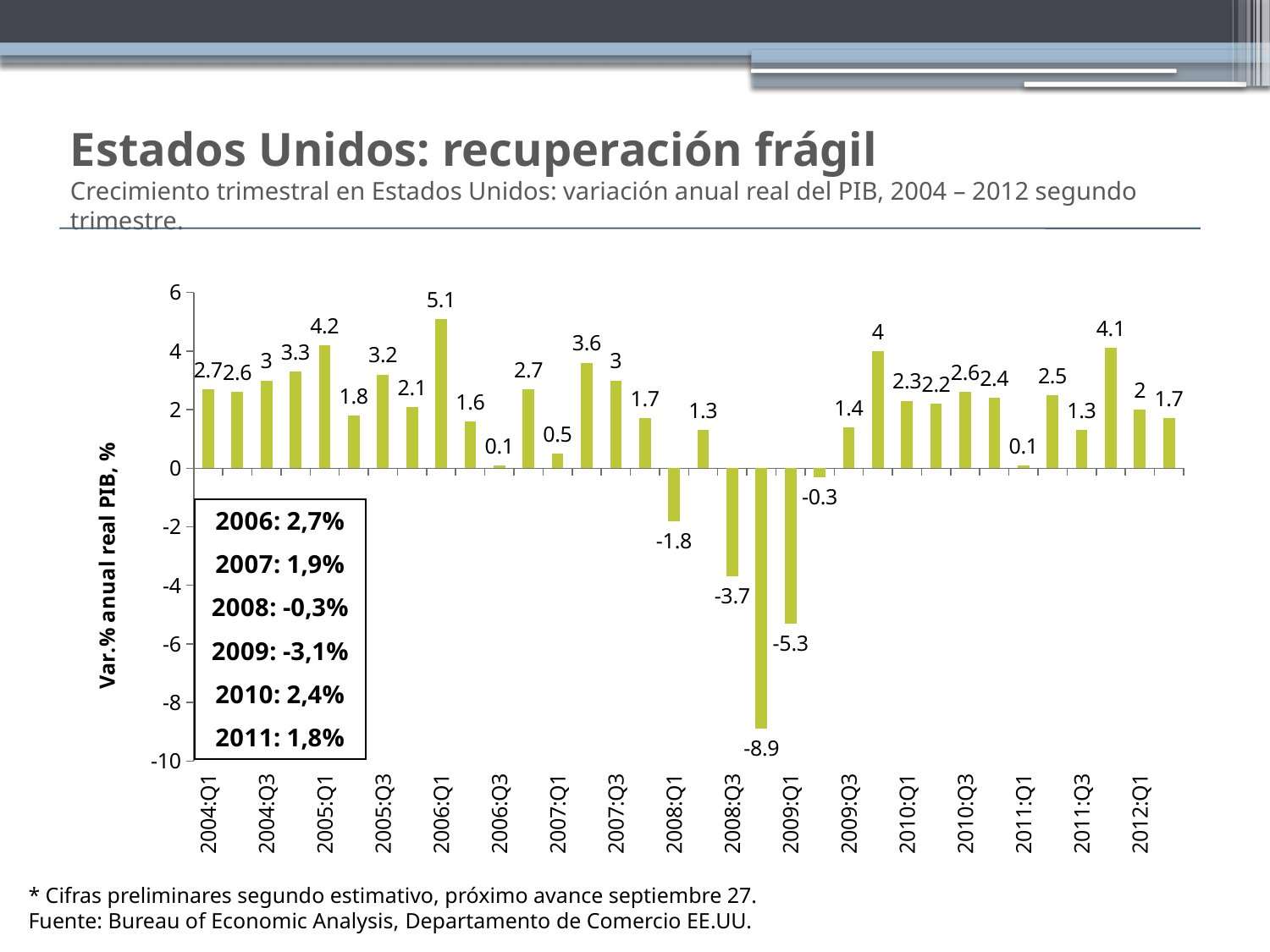
What is the title of the vertical axis? Var.% anual real PIB, % What kind of chart is shown on the slide? bar chart What is the value for 2006:Q1? 5.1 What is the lowest value shown in the chart? -8.9 How many bars (quarters) are plotted in the chart? 34 Which quarter has the highest value in the chart? 2006:Q1 What is the value for 2012:Q1? 2 Which is larger, the value for 2005:Q1 or the value for 2007:Q1? 2005:Q1 What is the value for 2009:Q1? -5.3 What is the difference between the values for 2006:Q1 and 2009:Q1? 10.4 According to the box inside the chart, what was the annual value for 2009? -3,1% What is the value for 2011:Q1? 0.1